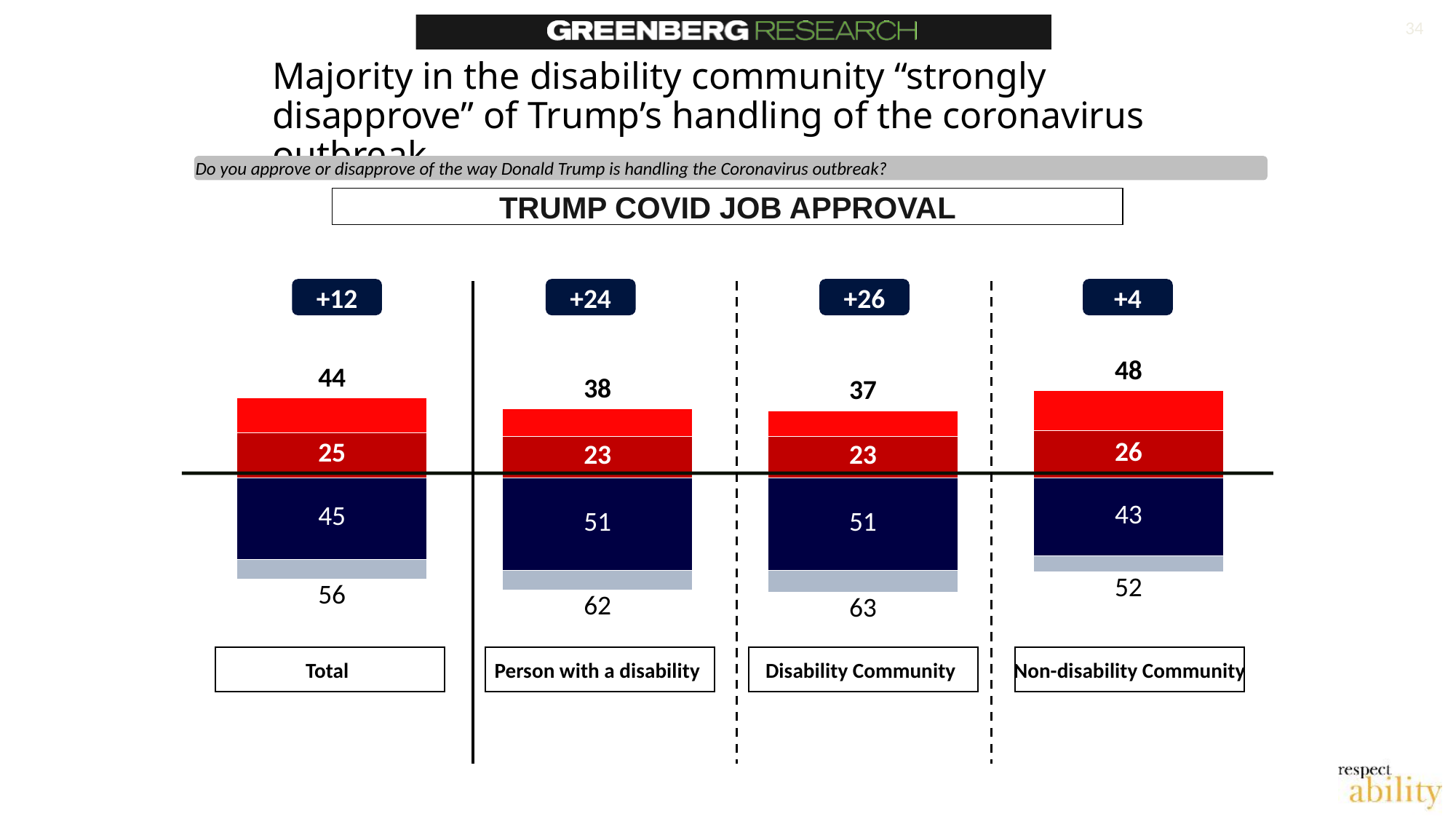
What number is printed in the dark navy segment of the bar for Person with a disability? 51 What number is printed above the bar for Non-disability Community? 48 How many groups (categories) are shown along the bottom of the chart? 4 What number is printed in the dark red segment of the Total bar? 25 What number is printed below the bar for Disability Community? 63 Which category has the highest number printed above its bar? Non-disability Community What value is shown in the box above the Total bar? +12 What kind of chart is shown under the title "TRUMP COVID JOB APPROVAL"? bar chart Which category has the lowest number printed above its bar? Disability Community Which is larger: the number in the dark navy segment for Person with a disability or for Non-disability Community? Person with a disability What is the difference between the number printed above the Non-disability Community bar and the number printed above the Disability Community bar? 11 Which category has the highest value in the box above its bar? Disability Community